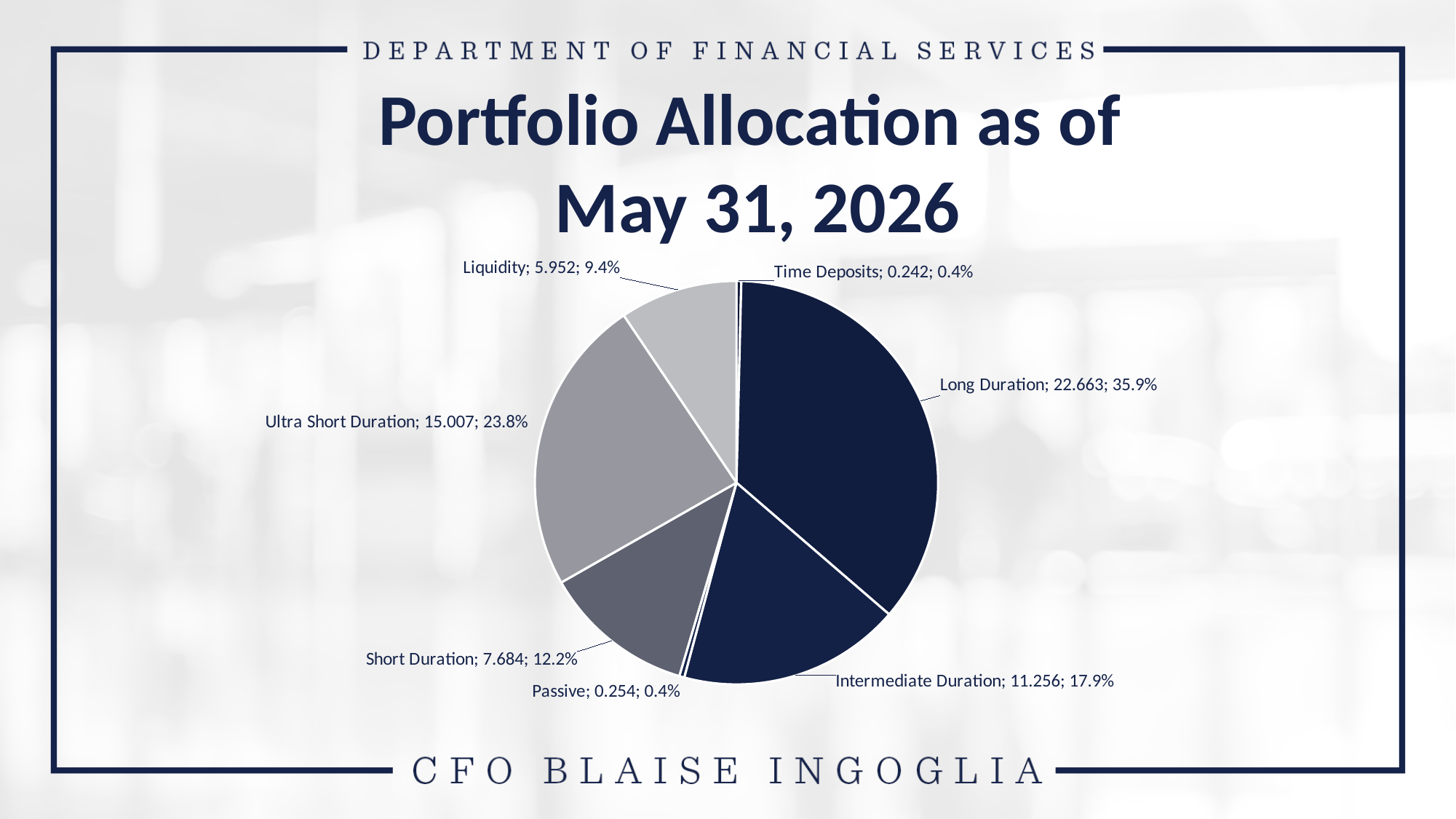
Which is larger, Short Duration or Intermediate Duration? Intermediate Duration What is the value shown for Passive? 0.254 What is the value shown for Long Duration? 22.663 Which category has the largest slice of the pie? Long Duration What percentage share does Short Duration have? 12.2% What percentage share does Ultra Short Duration have? 23.8% What percentage share does Liquidity have? 9.4% How many slices does the pie chart have? 7 What is the difference between the values for Long Duration and Ultra Short Duration? 7.656 What is the value shown for Intermediate Duration? 11.256 What type of chart is shown on the slide? Pie chart What is the title of the chart? Portfolio Allocation as of May 31, 2026